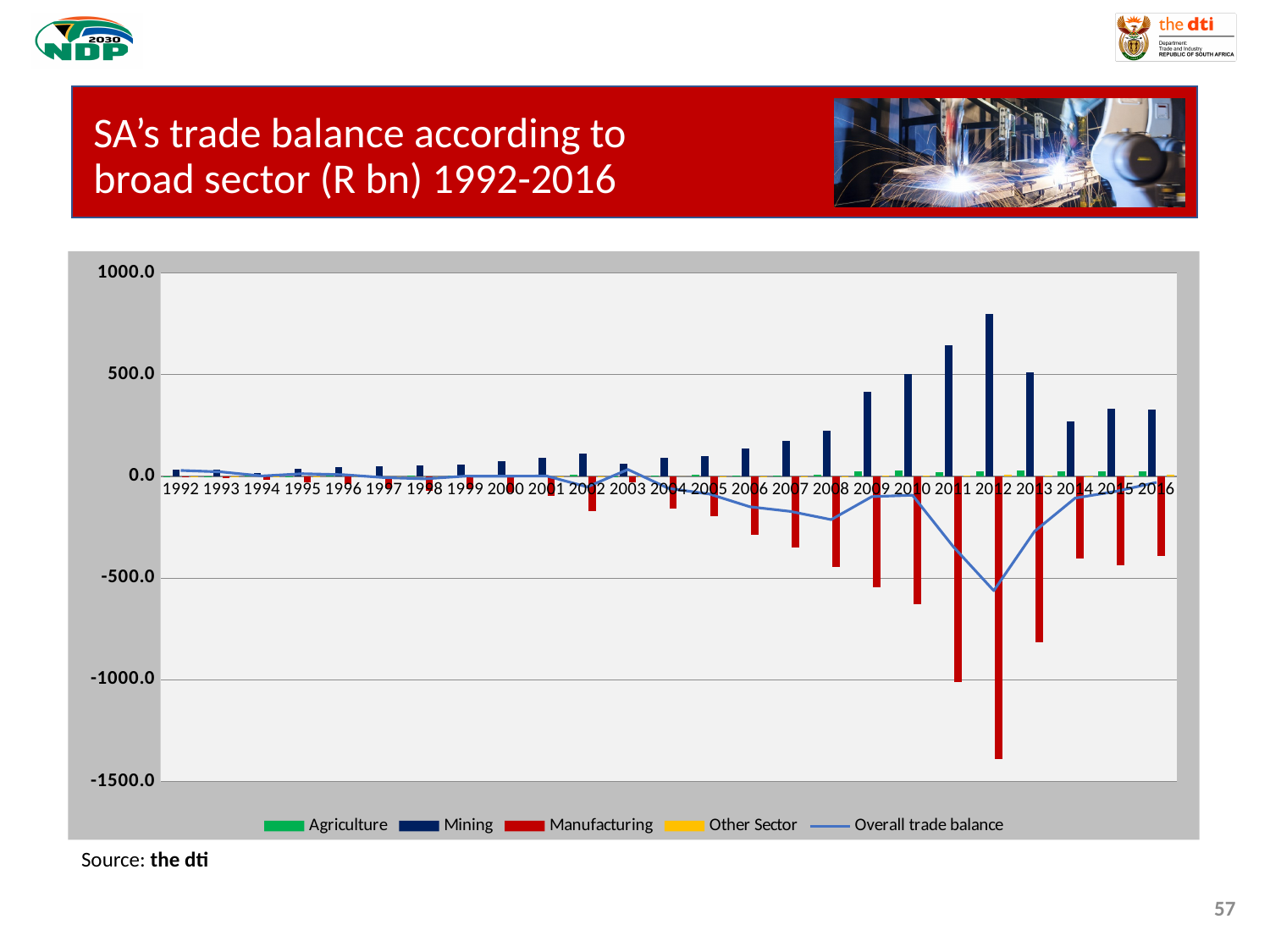
What kind of chart is shown on the slide? A bar chart with a line overlay Do the Mining bars generally rise or fall from 1992 to 2012? rise What colour represents Manufacturing in the chart's legend? Red How many series does the chart's legend list? 5 Is the Manufacturing value for 2013 greater or less than -500.0? less Which is larger, the Mining value for 2012 or the Mining value for 2011? 2012 In which year is the Manufacturing bar the lowest (most negative)? 2012 Is the Mining value for 2012 greater or less than 500.0? greater In which year is the Mining bar the highest? 2012 Is the Manufacturing value for 2012 greater or less than -1000.0? less How many years are plotted along the x axis of the chart? 25